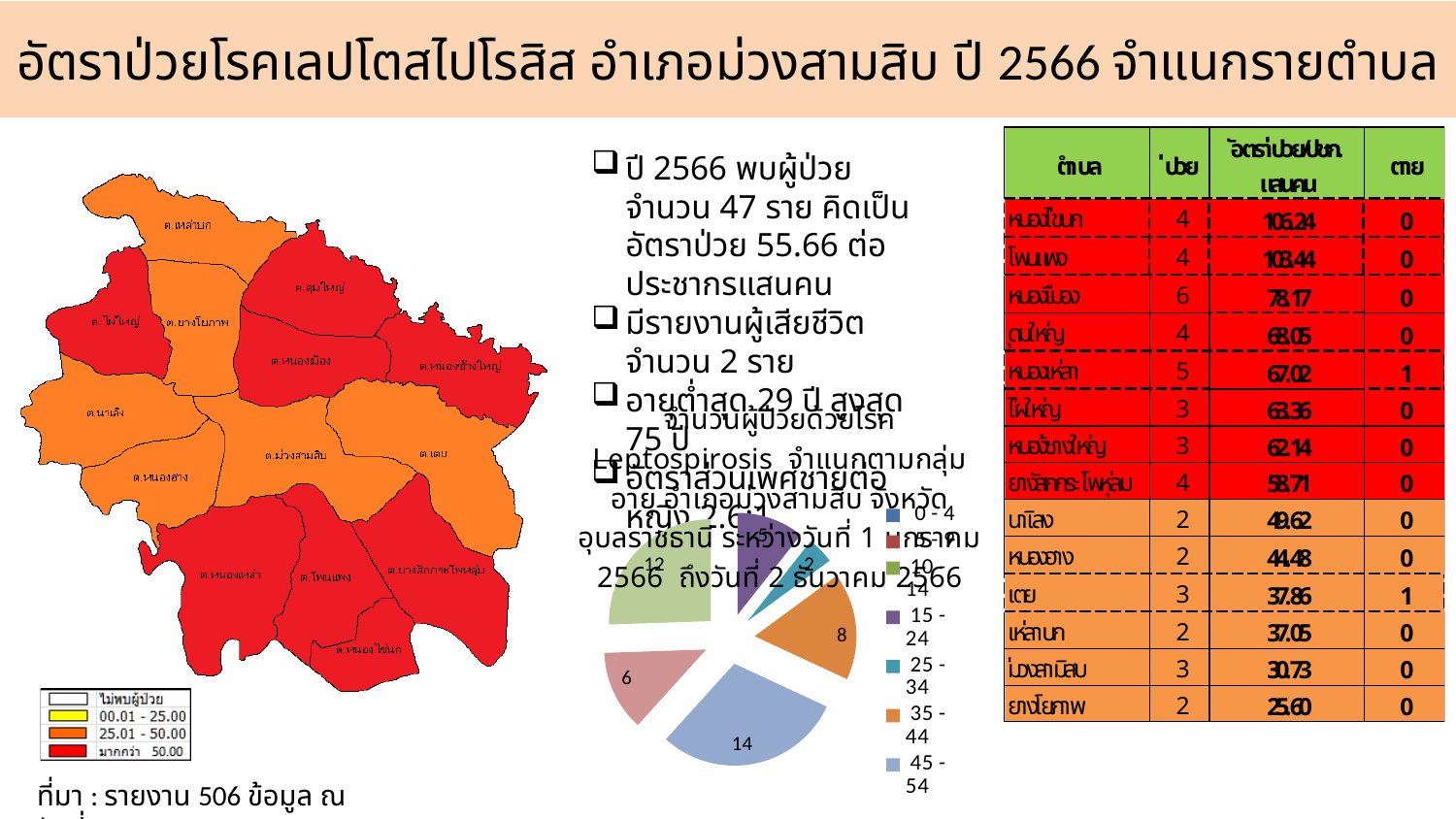
In the pie chart, what is the value of the smallest slice? 2 In the pie chart, what is the value of the light blue slice (age group 45 - 54)? 14 In the pie chart legend, which age group is listed first? 0 - 4 In the pie chart, what is the value of the orange slice (age group 35 - 44)? 8 In the pie chart legend, what colour represents the age group 45 - 54? light blue How many slices with data labels are shown in the pie chart? 6 In the pie chart, what is the value of the largest slice? 14 In the pie chart, what is the value of the green slice? 12 In the pie chart, which slice is larger: the green slice or the orange slice? the green slice In the pie chart, what is the value of the pink slice? 6 What kind of chart is shown in the middle of the slide? pie chart In the pie chart, what is the difference between the light blue slice (14) and the orange slice (8)? 6